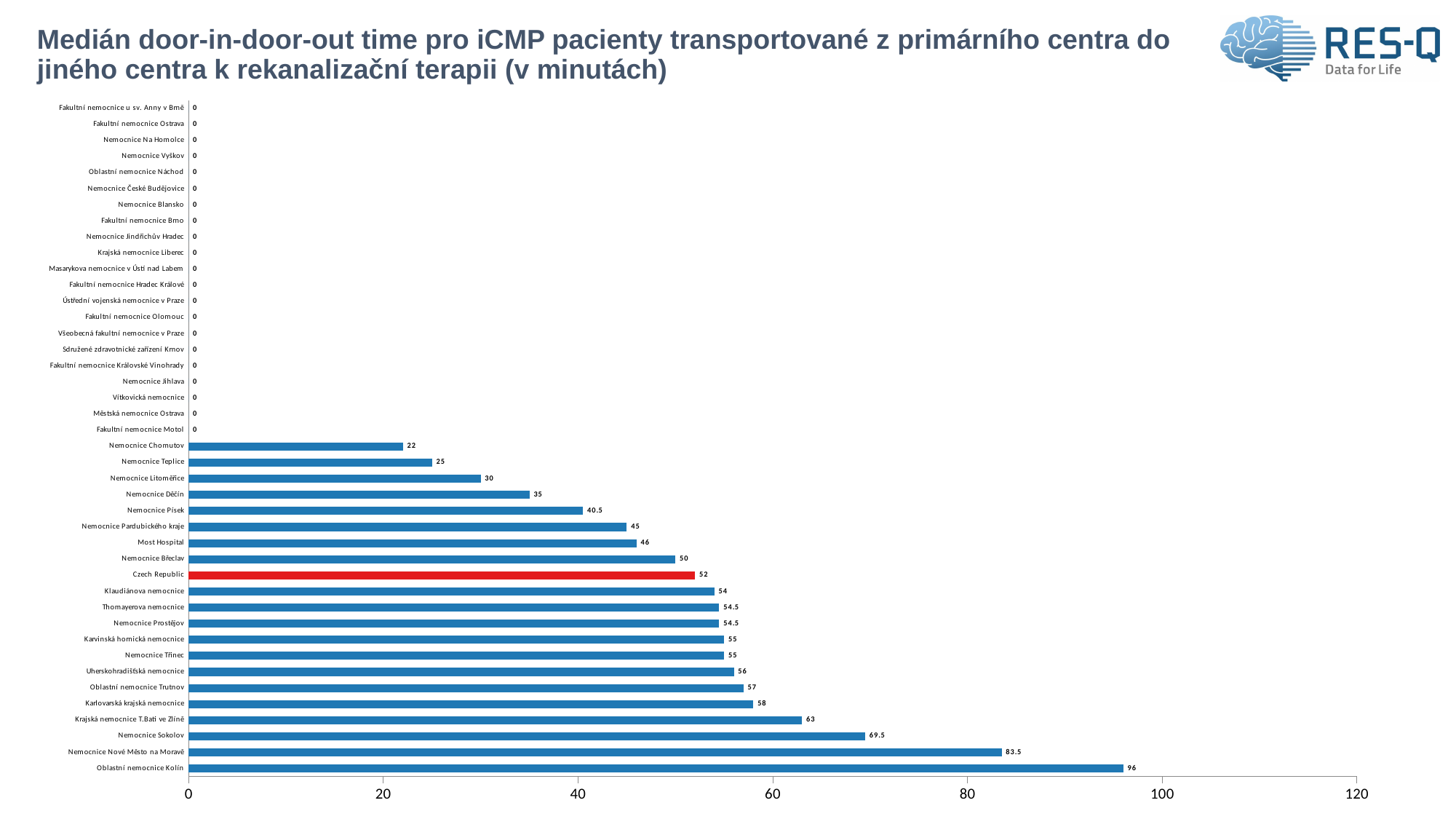
Which bar is highlighted in red? Czech Republic Is the value for Krajská nemocnice T.Bati ve Zlíně greater or less than 60? greater Which is larger, the value for Nemocnice Teplice or Nemocnice Litoměřice? Nemocnice Litoměřice What is the value for Oblastní nemocnice Kolín? 96 Which hospital has the highest median door-in-door-out time? Oblastní nemocnice Kolín What kind of chart is shown? bar chart What is the difference between Oblastní nemocnice Kolín and Nemocnice Nové Město na Moravě? 12.5 How many hospitals have a value of 0? 21 Which hospital has the lowest non-zero value? Nemocnice Chomutov What is the value for Nemocnice Sokolov? 69.5 What is the value for Nemocnice Písek? 40.5 What is the value for Czech Republic? 52